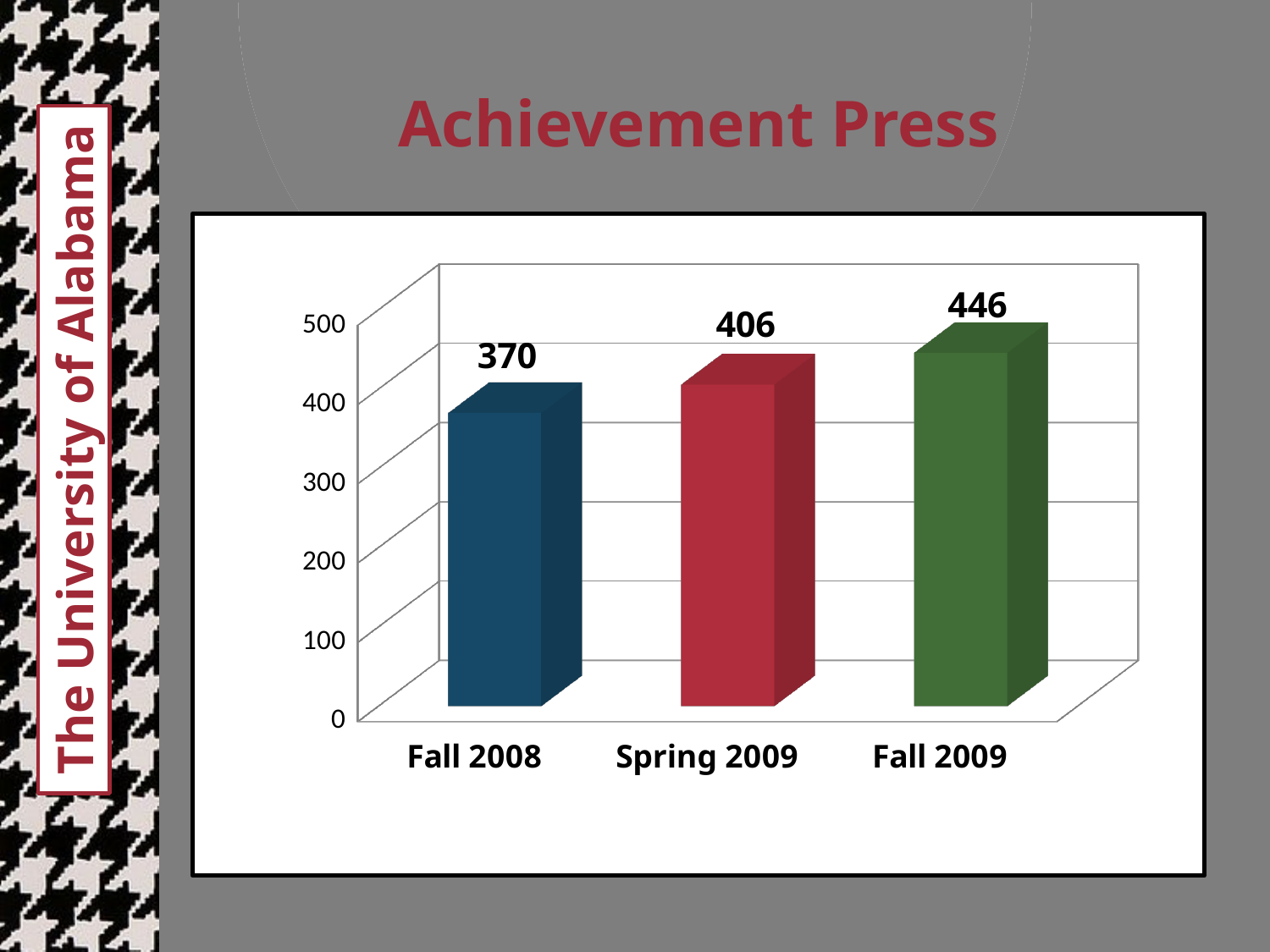
Which is larger, the value for Spring 2009 or the value for Fall 2009? Fall 2009 What is the value for Fall 2008? 370 Which category has the highest value? Fall 2009 Which category has the lowest value? Fall 2008 What is the value for Fall 2009? 446 What is the difference between the values for Fall 2009 and Fall 2008? 76 Do the values rise or fall from Fall 2008 to Fall 2009? rise What is the difference between the values for Spring 2009 and Fall 2008? 36 How many categories are shown on the x axis? 3 What is the value for Spring 2009? 406 Is the value for Fall 2008 greater or less than 400? less What kind of chart is shown on the slide? bar chart